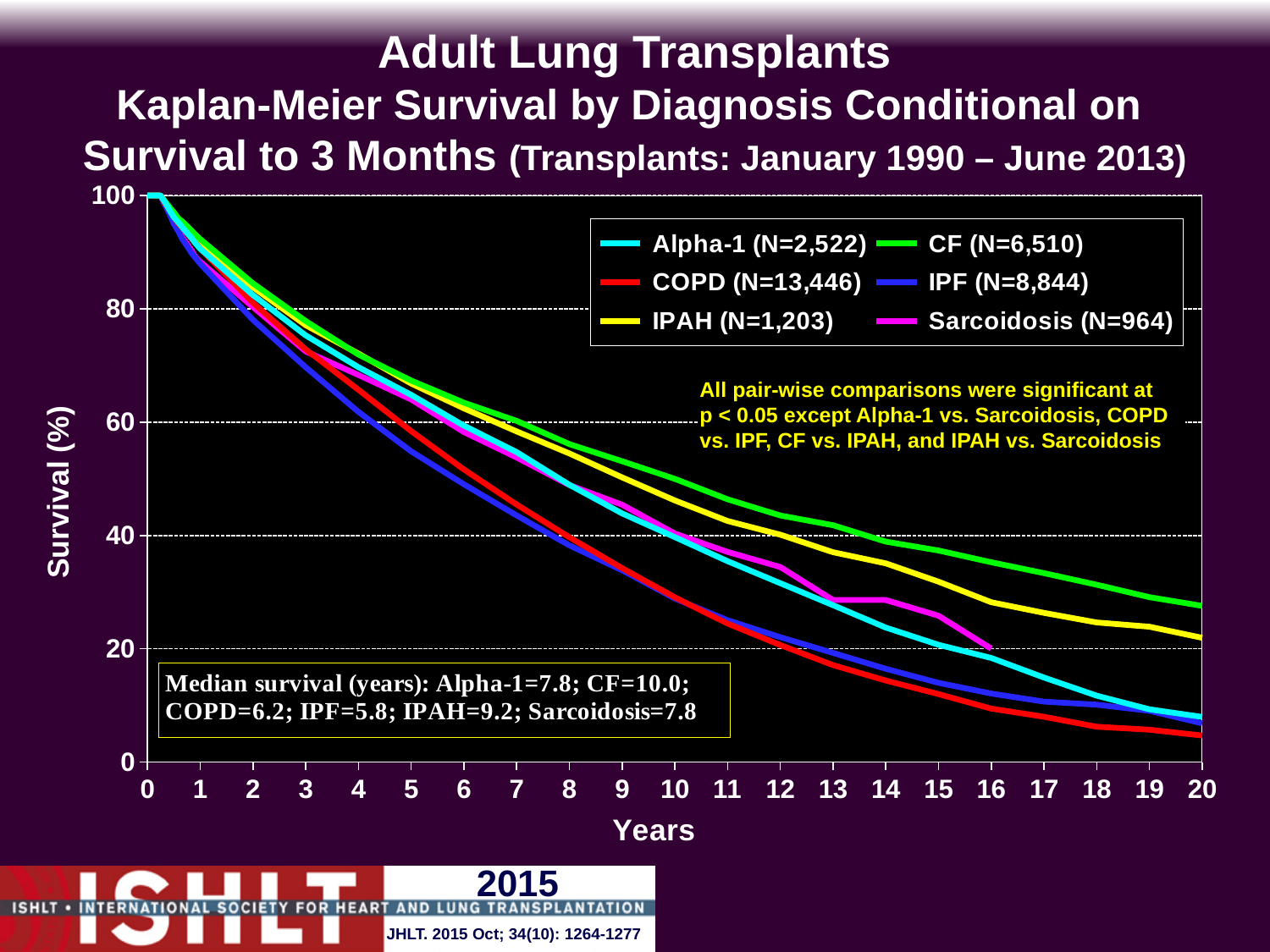
What kind of chart is shown on the slide? line chart Is the survival for CF at 20 years greater or less than 20%? greater Is the survival for COPD at 20 years greater or less than 10%? less At 15 years, which has higher survival: CF or IPAH? CF What is the median survival in years for CF according to the text box? 10.0 How many diagnosis groups does the legend list? 6 Which diagnosis group has the highest survival at 10 years? CF Is the survival for IPF at 10 years greater or less than 40%? less Do the survival curves rise or fall as years since transplant increase? fall What is the N for COPD shown in the legend? 13,446 What is the difference between the median survival of CF and IPF in years? 4.2 Which diagnosis group has the highest survival at 20 years? CF